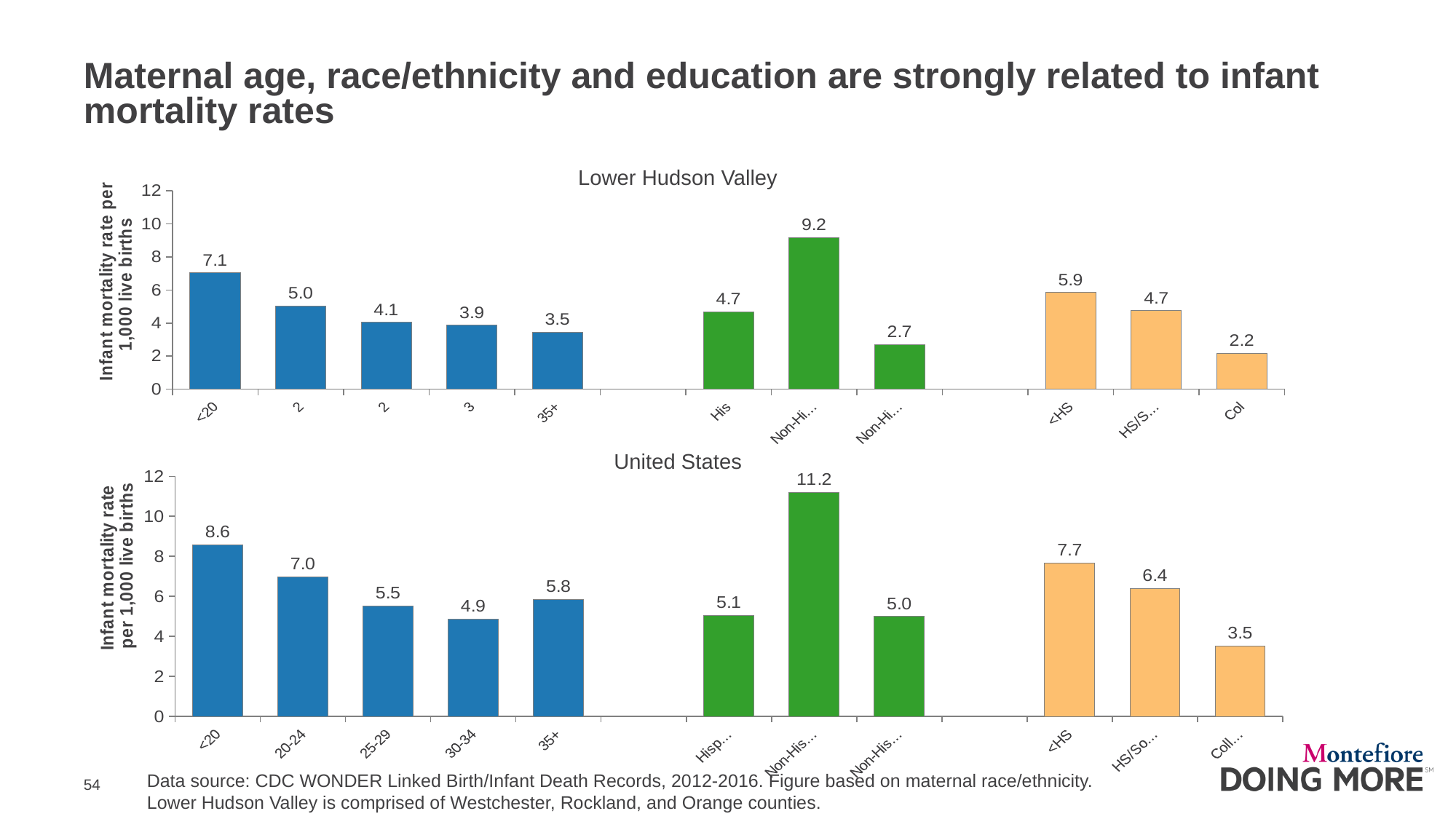
On the United States chart, what is the value for the <HS education category? 7.7 On the United States chart, what is the difference between the values for mothers aged <20 and 35+? 2.8 On the Lower Hudson Valley chart, what is the highest value labelled on any bar? 9.2 On the Lower Hudson Valley chart, what is the difference between the values for mothers aged <20 and 35+? 3.6 On the Lower Hudson Valley chart, which has the larger value: mothers aged <20 or the <HS education category? <20 On the Lower Hudson Valley chart, what is the infant mortality rate for mothers aged <20? 7.1 On the United States chart, what is the highest value labelled on any bar? 11.2 On the United States chart, do the values rise or fall across the age groups from <20 to 30-34? Fall What type of chart is the Lower Hudson Valley chart? Bar chart How many bars are plotted on the United States chart? 11 On the Lower Hudson Valley chart, what is the value for mothers aged 35+? 3.5 On the United States chart, what is the infant mortality rate for mothers aged 30-34? 4.9